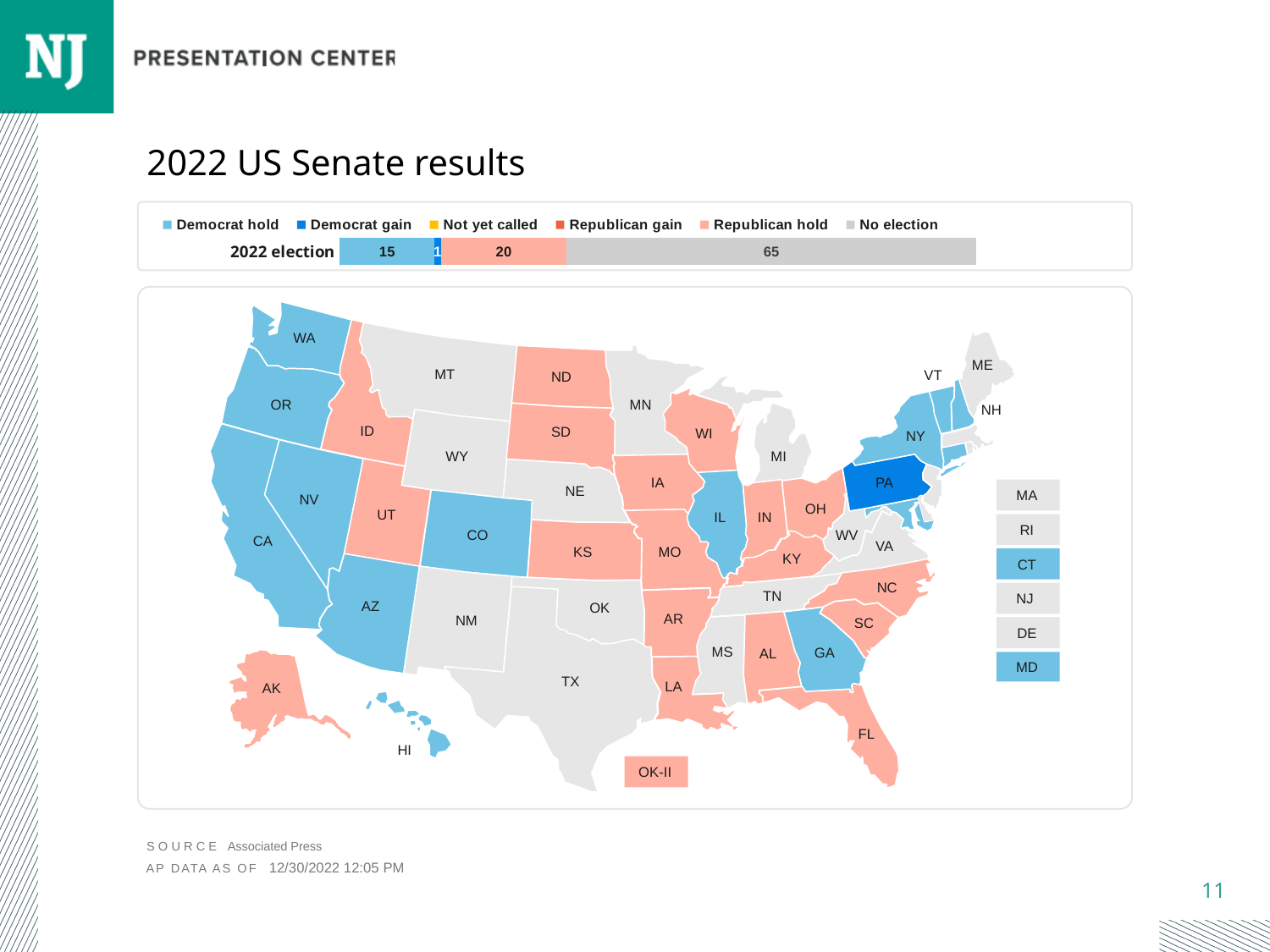
In the stacked bar chart, what is the total of all labelled segments for the 2022 election? 101 In the stacked bar chart, which is larger, Democrat hold or Republican hold? Republican hold In the stacked bar chart, what is the value for No election in the 2022 election? 65 In the stacked bar chart, what is the value for Democrat hold in the 2022 election? 15 How many entries does the legend of the stacked bar chart list? 6 In the stacked bar chart, what is the value for Democrat gain in the 2022 election? 1 On the map, which state is coloured as a Democrat gain? PA In the stacked bar chart, which category has the largest value? No election In the stacked bar chart, what is the value for Republican hold in the 2022 election? 20 What kind of chart is used to show the 2022 election seat breakdown? Stacked bar chart In the stacked bar chart, which labelled category has the smallest value? Democrat gain In the stacked bar chart, what is the difference between Republican hold and Democrat hold? 5